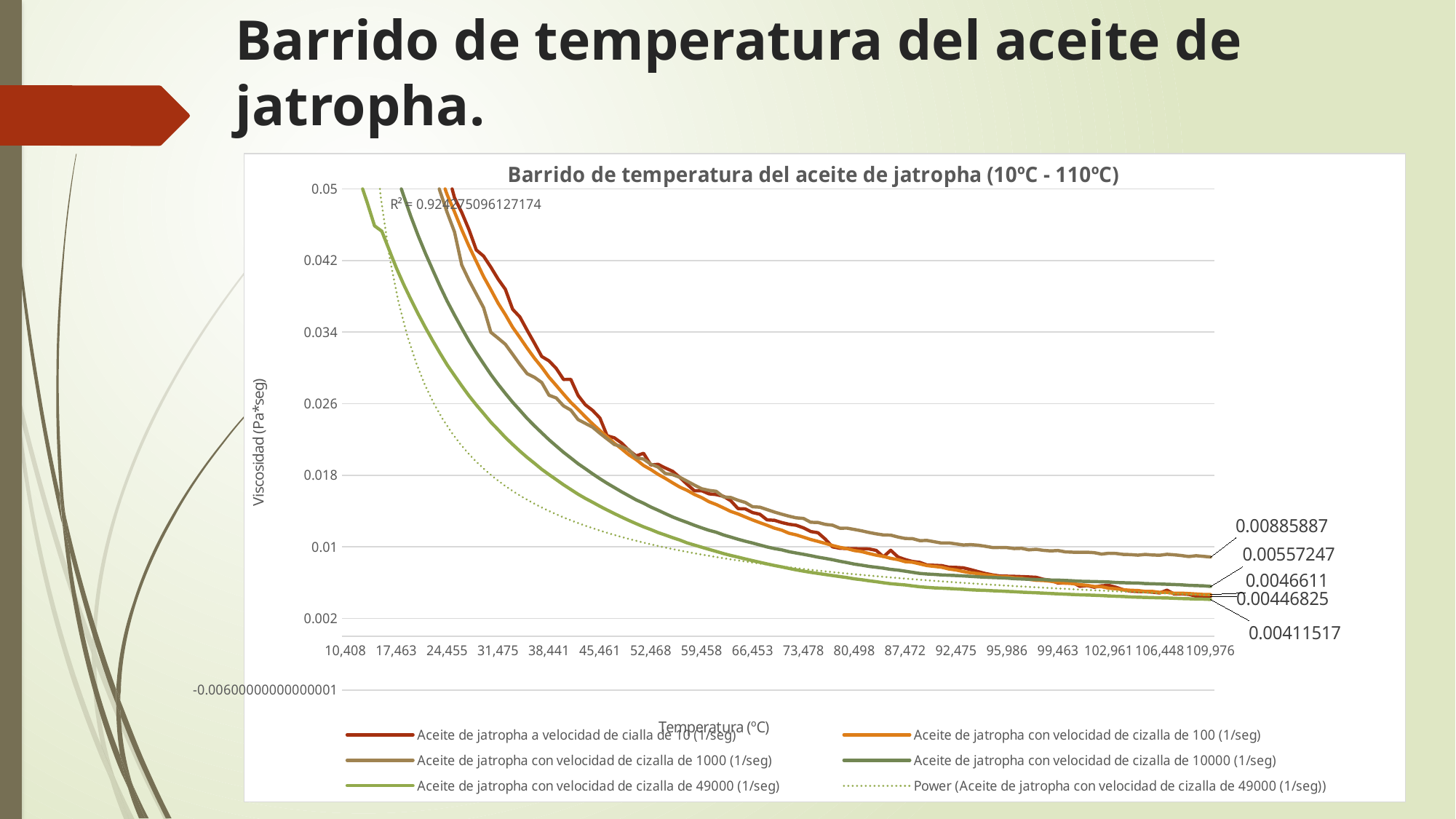
What is the final labelled viscosity value for the series 'Aceite de jatropha con velocidad de cizalla de 49000 (1/seg)'? 0.00411517 What is the difference between the highest end label (0.00885887) and the lowest end label (0.00411517)? 0.0047437 As temperature increases along the x axis, does the viscosity rise or fall? Fall Which series has the highest viscosity at the right end of the chart? Aceite de jatropha con velocidad de cizalla de 1000 (1/seg) At a temperature of 59,458, which series has the higher viscosity: the 1000 (1/seg) series or the 49000 (1/seg) series? Aceite de jatropha con velocidad de cizalla de 1000 (1/seg) What is the final labelled viscosity value for the series 'Aceite de jatropha con velocidad de cizalla de 1000 (1/seg)'? 0.00885887 What kind of chart is shown on the slide? Line chart Which series has the lowest viscosity at the right end of the chart? Aceite de jatropha con velocidad de cizalla de 49000 (1/seg) What is the title of the chart? Barrido de temperatura del aceite de jatropha (10ºC - 110ºC) How many entries does the chart legend list? 6 What is the label of the vertical axis? Viscosidad (Pa*seg) At the first temperature tick (10,408), is the viscosity of the 49000 (1/seg) series greater or less than 0.042? greater